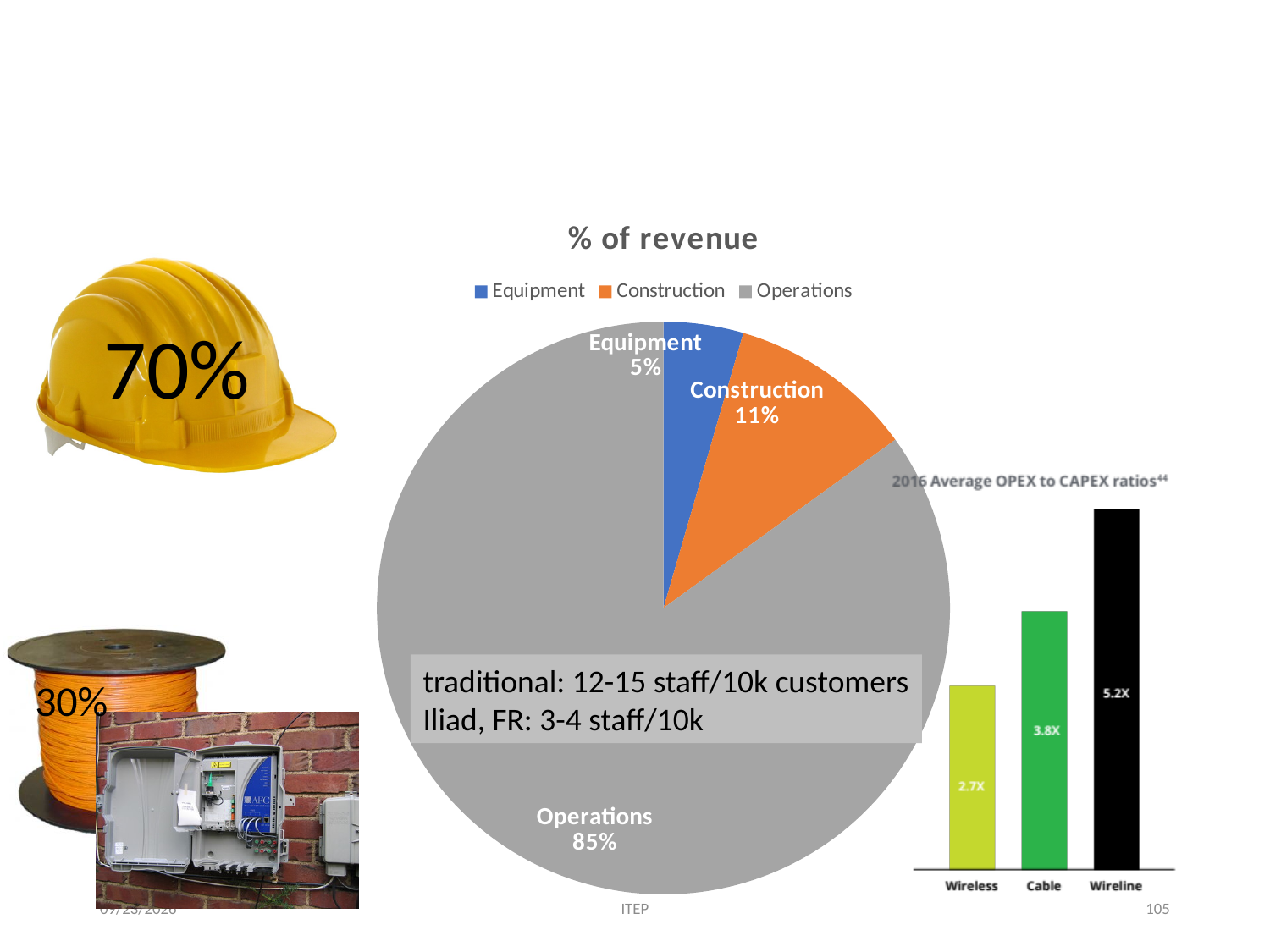
In the '2016 Average OPEX to CAPEX ratios' chart, which category has the highest ratio? Wireline In the '% of revenue' pie chart, which category has the largest slice? Operations In the '% of revenue' pie chart, what share does Operations have? 85% What kind of chart is the '2016 Average OPEX to CAPEX ratios' chart? Bar chart In the '2016 Average OPEX to CAPEX ratios' chart, what is the value for Wireline? 5.2X In the '2016 Average OPEX to CAPEX ratios' chart, what is the value for Wireless? 2.7X In the '2016 Average OPEX to CAPEX ratios' chart, is the value for Cable larger or smaller than the value for Wireless? Larger In the '% of revenue' pie chart, how many categories does the legend list? 3 What kind of chart is the '% of revenue' chart? Pie chart In the '% of revenue' pie chart, what share does Equipment have? 5% In the '% of revenue' pie chart, what share does Construction have? 11% In the '% of revenue' pie chart, which category has the smallest slice? Equipment